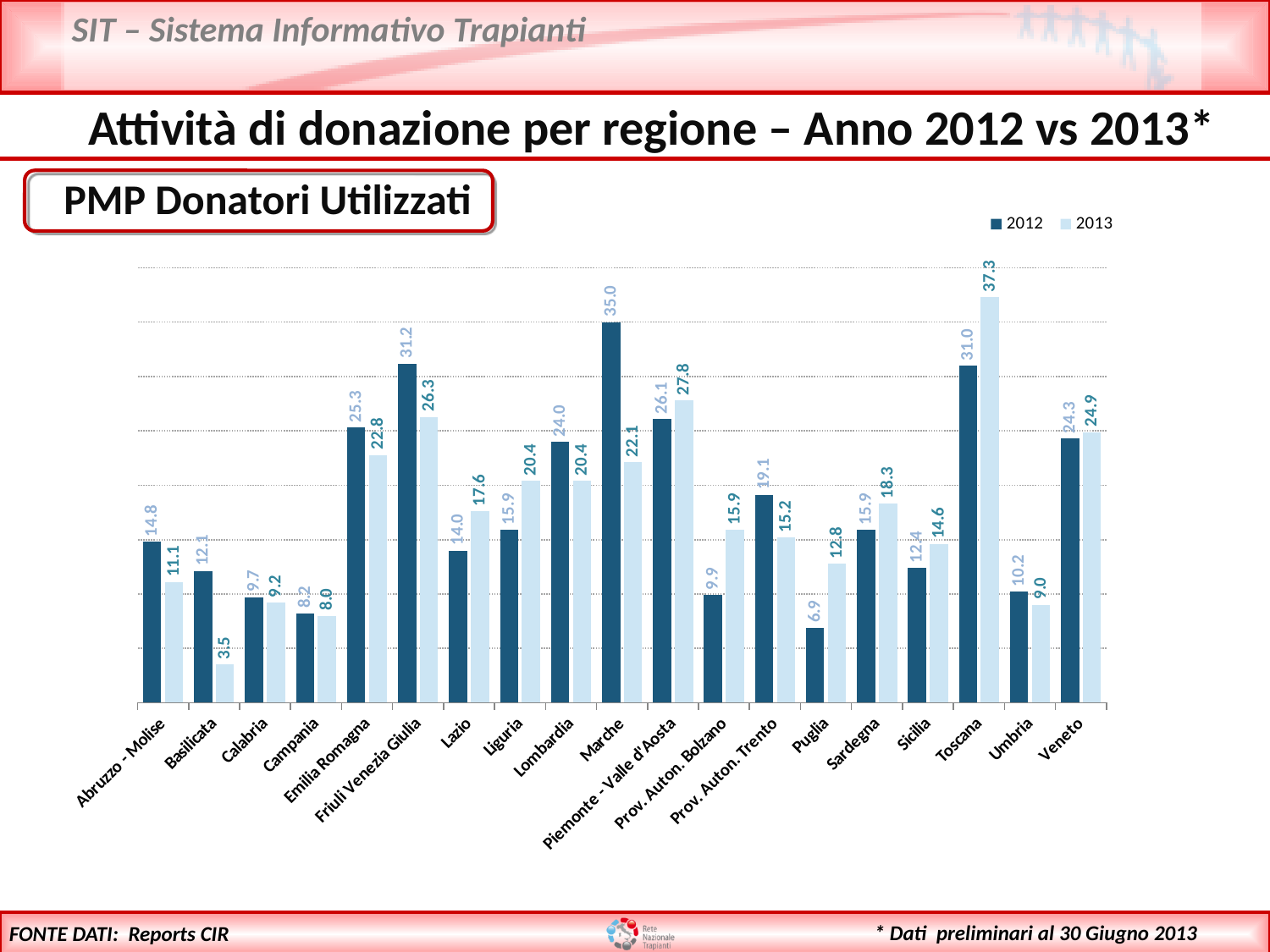
Which region has the highest 2013 value? Toscana What is the 2012 value for Prov. Auton. Bolzano? 9.9 Which region has the lowest 2012 value? Puglia Which region has the lowest 2013 value? Basilicata How many series does the legend list? 2 What is the difference between the 2013 and 2012 values for Toscana? 6.3 How many regions are shown on the x axis? 19 What is the 2013 value for Basilicata? 3.5 Which is larger for Lazio, the 2012 value or the 2013 value? 2013 Which region has the highest 2012 value? Marche What is the 2012 value for Marche? 35.0 What is the 2013 value for Toscana? 37.3